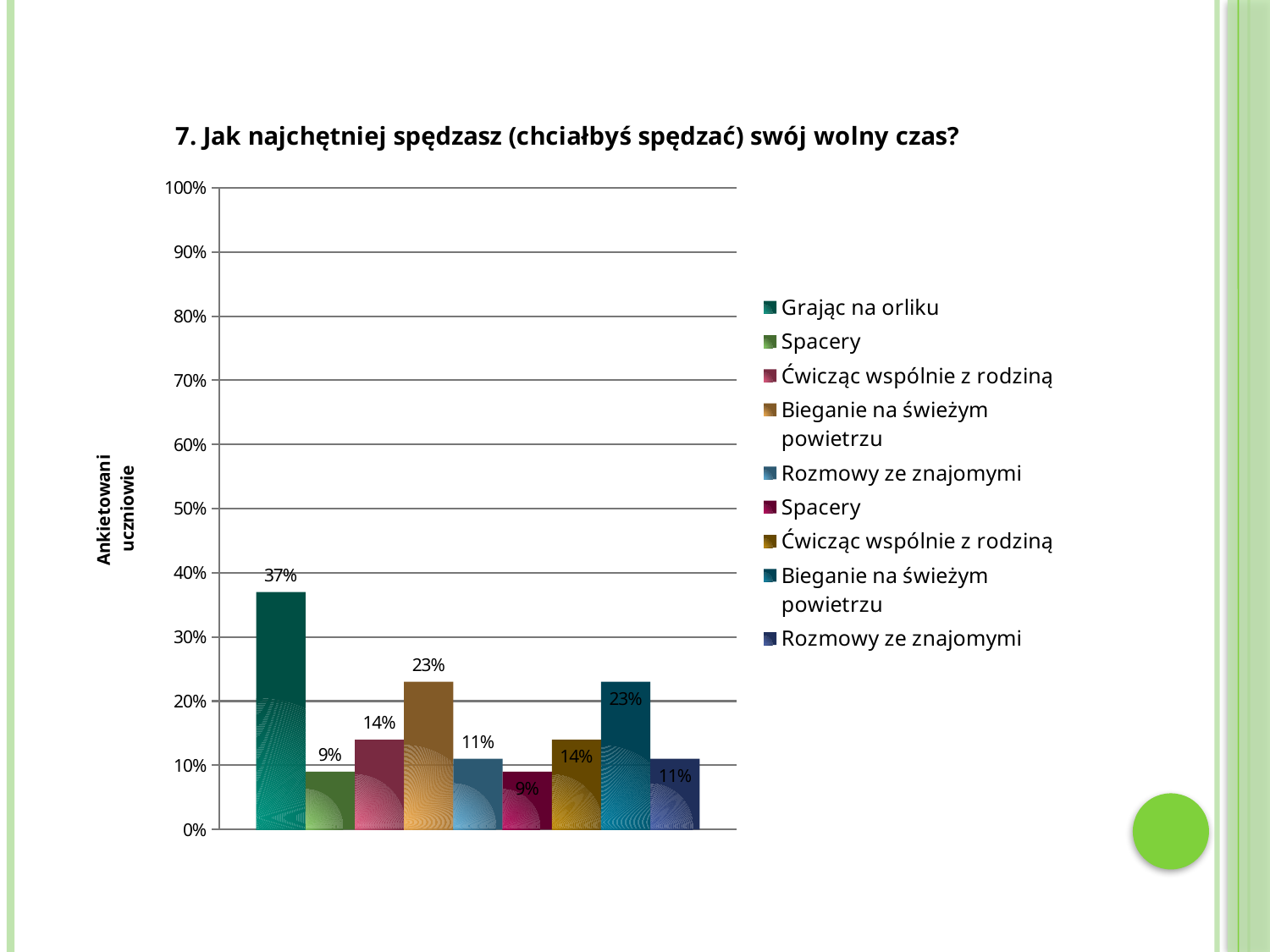
What is the difference between the values for "Grając na orliku" and "Bieganie na świeżym powietrzu"? 14% What is the difference between the values for "Ćwicząc wspólnie z rodziną" and "Spacery"? 5% How many entries does the legend list? 9 What is the value for "Grając na orliku"? 37% What kind of chart is shown on the slide? bar chart Which series has the highest value? Grając na orliku What is the value for "Spacery"? 9% Which is larger, the value for "Ćwicząc wspólnie z rodziną" or the value for "Rozmowy ze znajomymi"? Ćwicząc wspólnie z rodziną What is the value for "Bieganie na świeżym powietrzu"? 23% How many bars are plotted on the chart? 9 Is the value for "Grając na orliku" greater or less than 30%? greater What is the value for "Rozmowy ze znajomymi"? 11%